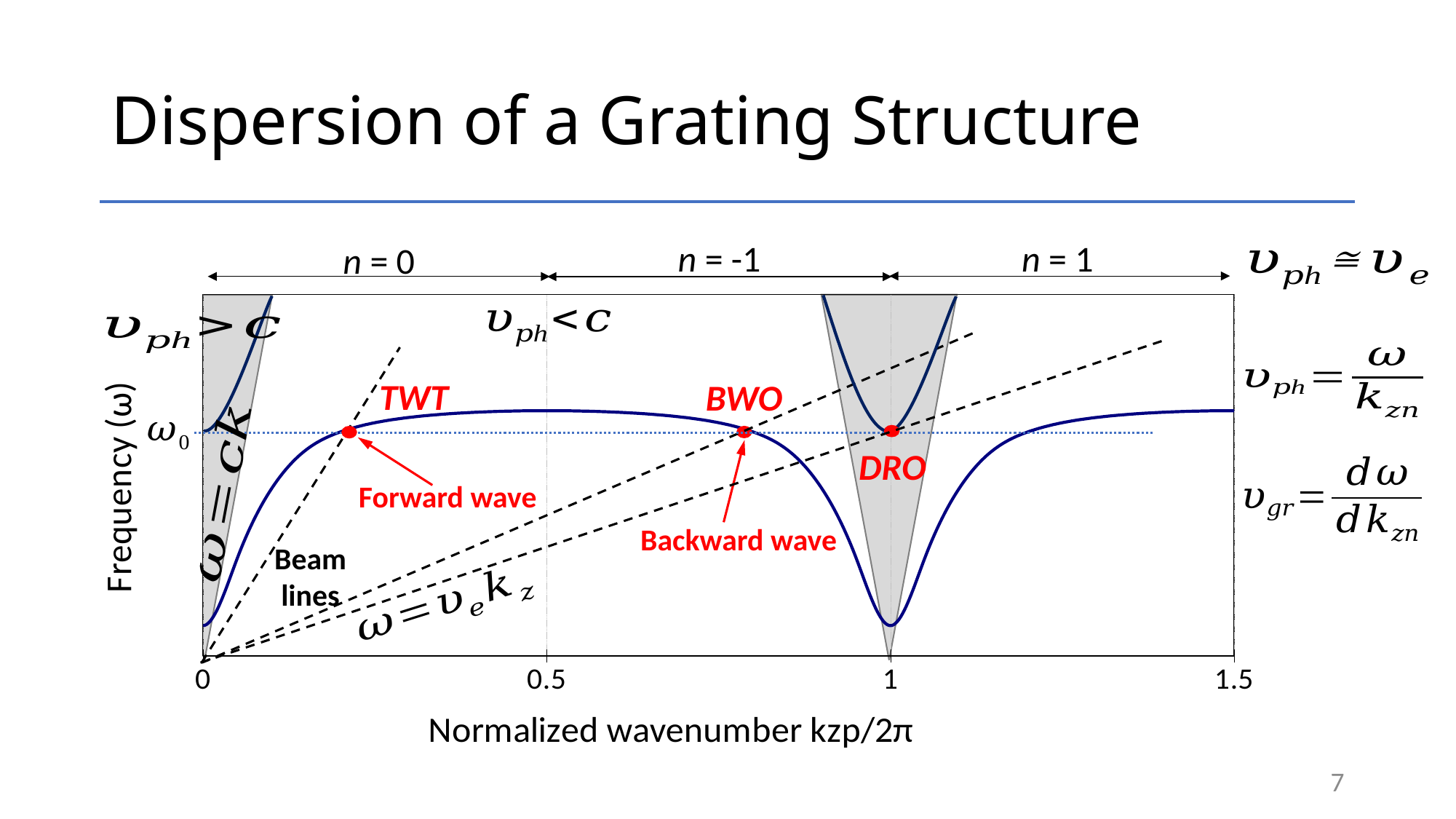
Is the normalized wavenumber of the TWT point greater or less than 0.5? less What kind of chart is shown on the slide? line chart How many labeled operating points (red dots) are marked on the dispersion curve? 3 Which labeled operating point lies at a normalized wavenumber of 1? DRO Does the dispersion curve rise or fall as the normalized wavenumber increases from 0.5 to 1? fall What is the largest tick value shown on the x axis? 1.5 Is the normalized wavenumber of the BWO point greater or less than 0.5? greater What is the title of the x axis? Normalized wavenumber kzp/2π Which labeled operating point is annotated as the 'Backward wave'? BWO In which space-harmonic region (n value) does the BWO point lie? n = -1 At which frequency level (marked on the y axis) do the TWT, BWO and DRO points all lie? ω0 Which labeled operating point is annotated as the 'Forward wave'? TWT